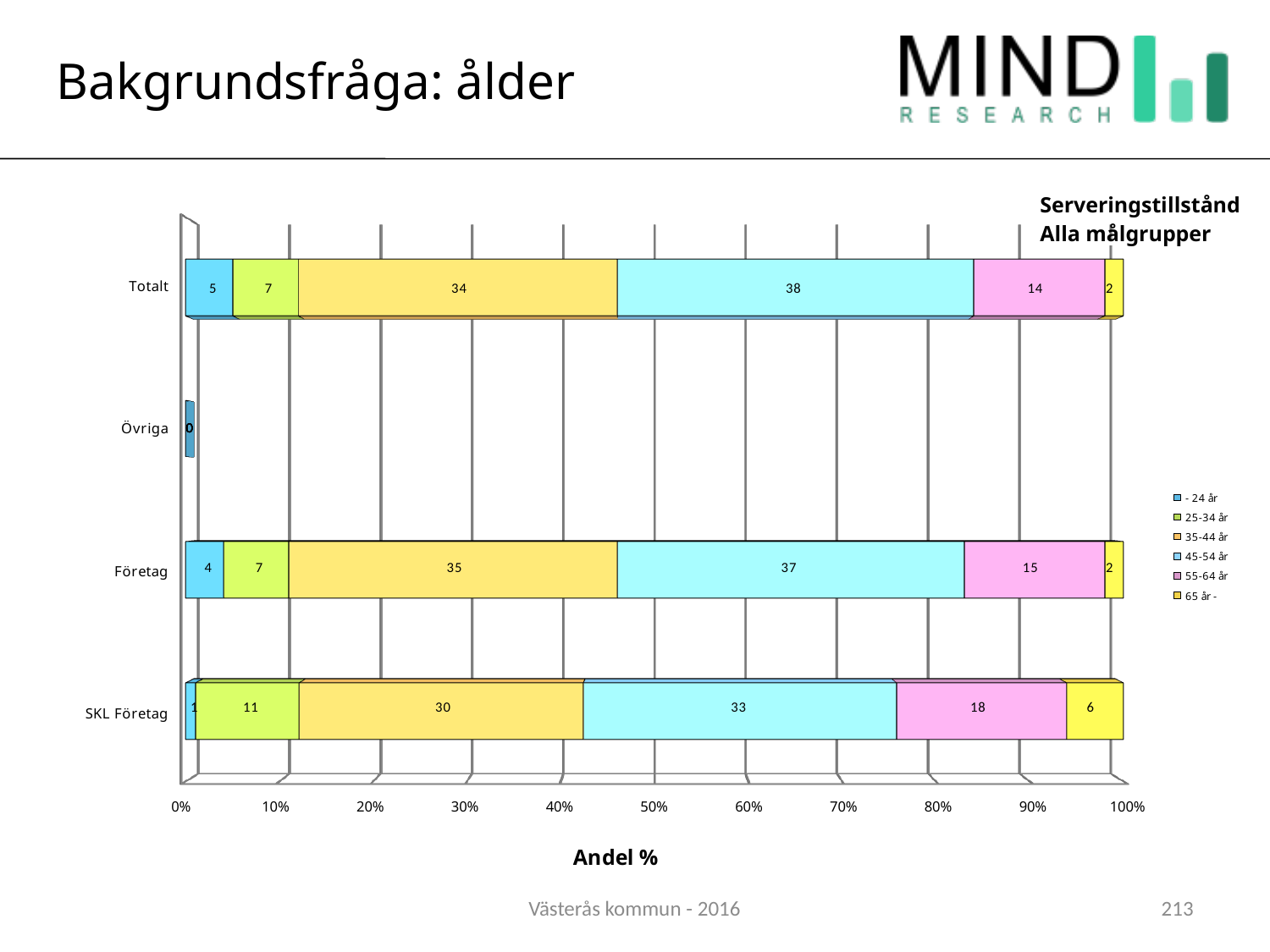
What is the value for 35-44 år in the Företag bar? 35 How many categories are shown on the vertical axis? 4 Which age group has the largest share in the Totalt bar? 45-54 år What is the value for 45-54 år in the Totalt bar? 38 What is the label of the x axis? Andel % What is the difference between the 25-34 år values for SKL Företag and Företag? 4 Which age group has the smallest share in the Företag bar? 65 år - What is the value for 65 år - in the SKL Företag bar? 6 What is the value for 55-64 år in the SKL Företag bar? 18 What kind of chart is shown on the slide? Stacked bar chart Which is larger: the 55-64 år value for SKL Företag or for Totalt? SKL Företag How many series does the legend list? 6